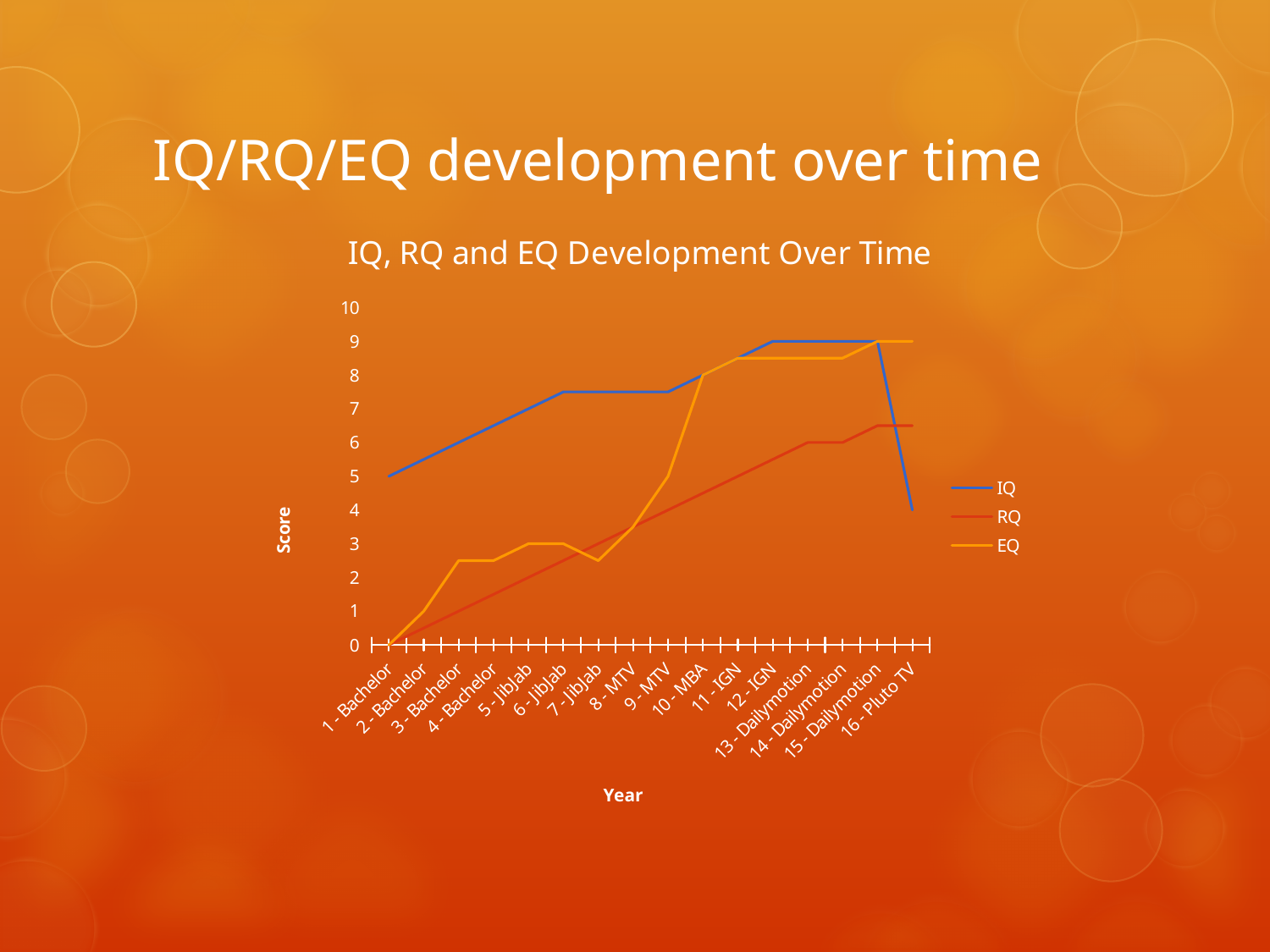
Does the RQ line rise or fall from 1 - Bachelor to 15 - Dailymotion? rise At 16 - Pluto TV, which is higher, IQ or RQ? RQ What is the label on the vertical axis? Score What is the IQ value at 1 - Bachelor? 5 At 8 - MTV, which is higher, IQ or EQ? IQ Is the RQ value at 16 - Pluto TV greater or less than 6? greater What kind of chart is shown on the slide? line chart Is the EQ value at 10 - MBA greater or less than 7? greater How many categories are shown along the x axis? 16 Is the IQ value at 16 - Pluto TV greater or less than 5? less What is the RQ value at 1 - Bachelor? 0 How many series does the legend list? 3